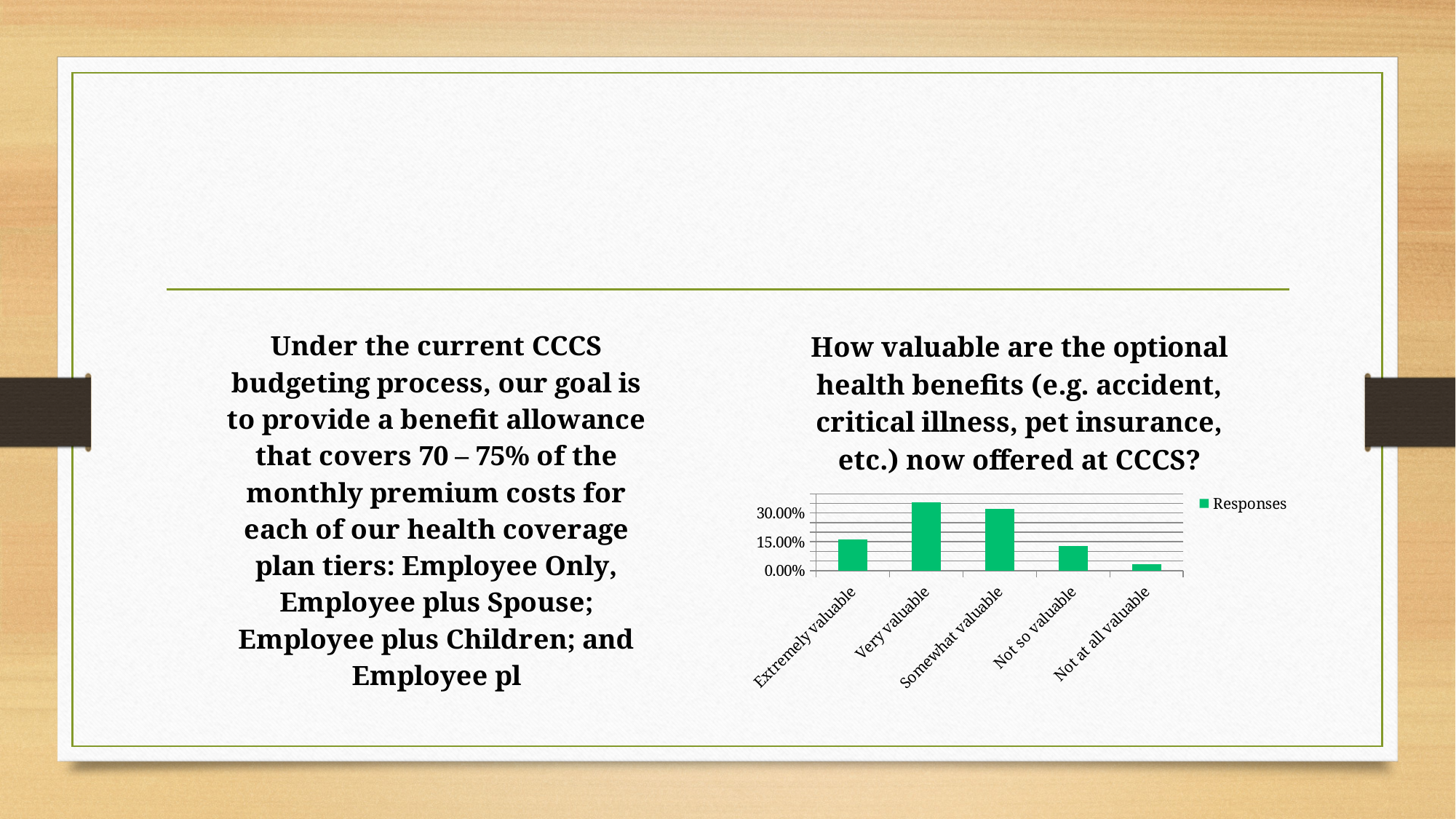
Which is larger, the value for Somewhat valuable or the value for Not so valuable? Somewhat valuable Which category has the lowest value in the chart? Not at all valuable Which category has the highest value in the chart? Very valuable How many categories are shown on the x axis of the chart? 5 What is the name of the series listed in the chart's legend? Responses Is the value for Very valuable greater or less than 30.00%? greater How many series does the chart's legend list? 1 Which is larger, the value for Very valuable or the value for Not at all valuable? Very valuable Do the values rise or fall from Somewhat valuable to Not at all valuable along the x axis? fall What kind of chart is shown on the slide? bar chart Is the value for Not so valuable greater or less than 15.00%? less Is the value for Not at all valuable greater or less than 15.00%? less